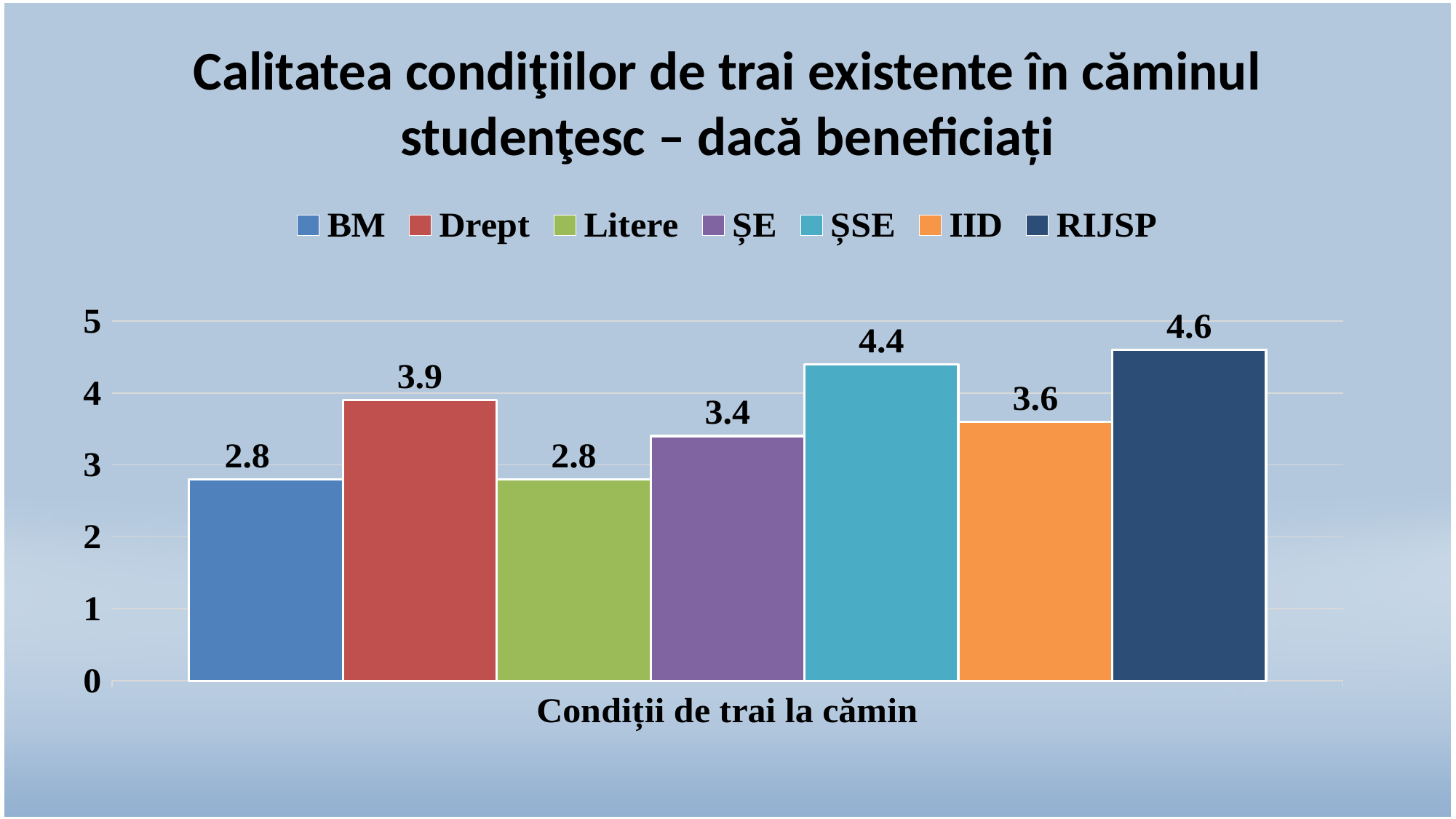
What is the value for ȘSE? 4.4 What is the x-axis label of the chart? Condiții de trai la cămin What is the difference between the values for ȘSE and ȘE? 1 Which two series share the same value of 2.8? BM and Litere What is the value for Drept? 3.9 What is the difference between the values for RIJSP and BM? 1.8 Which is larger, the value for Drept or the value for IID? Drept What is the value for IID? 3.6 Which series has the highest value? RIJSP What kind of chart is shown on the slide? bar chart Is the value for ȘE greater or less than 3? greater How many series does the legend list? 7